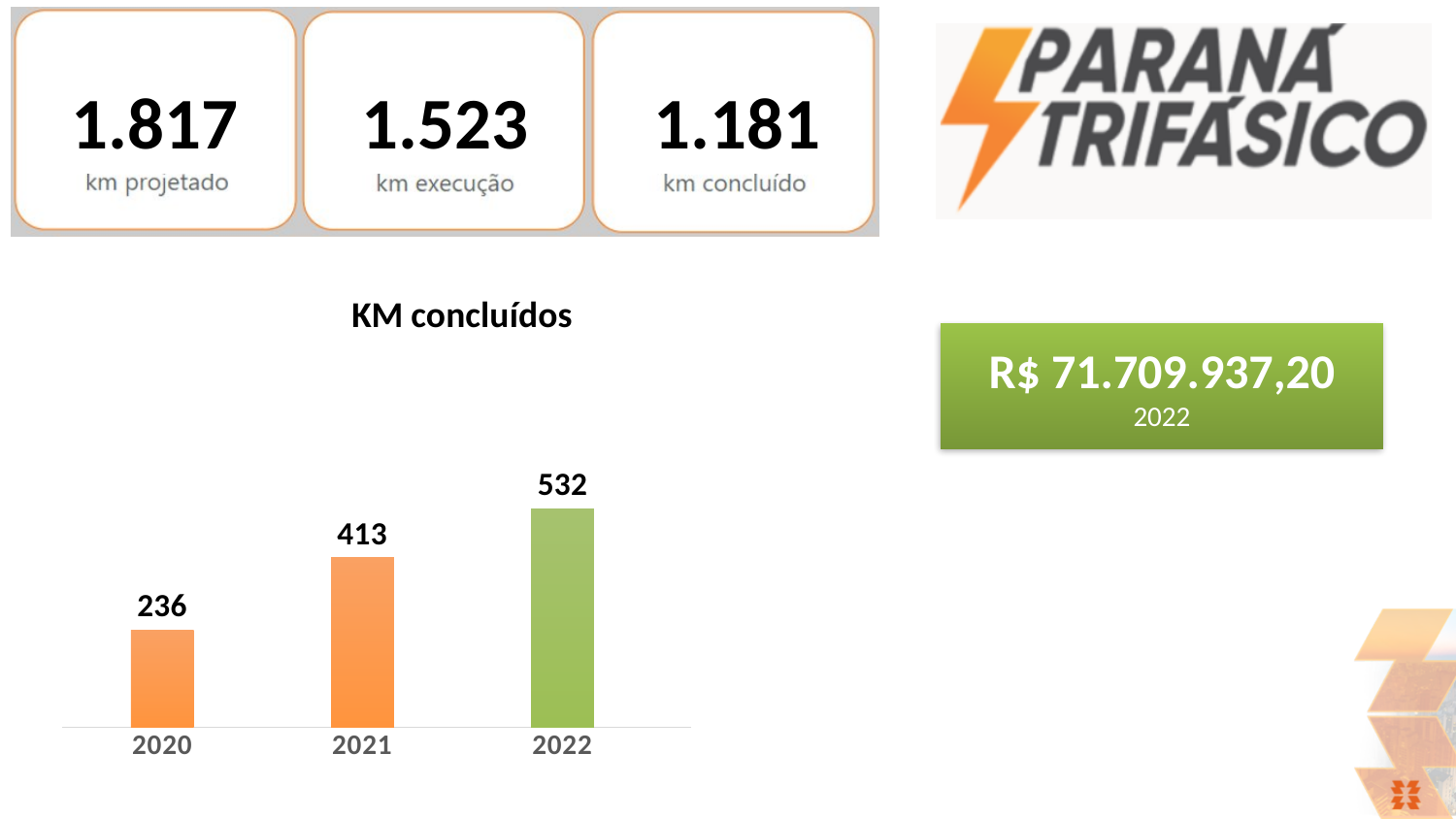
What is the difference between the 2022 and 2021 values in the KM concluídos chart? 119 Which year has the highest value in the KM concluídos chart? 2022 What is the title of the chart on the slide? KM concluídos What kind of chart is the KM concluídos chart? bar chart Which year has the lowest value in the KM concluídos chart? 2020 Which is larger in the KM concluídos chart, the value for 2020 or the value for 2021? 2021 What is the value for 2021 in the KM concluídos chart? 413 Do the values in the KM concluídos chart rise or fall from 2020 to 2022? rise How many years are shown in the KM concluídos chart? 3 What is the difference between the 2021 and 2020 values in the KM concluídos chart? 177 What is the value for 2020 in the KM concluídos chart? 236 What is the value for 2022 in the KM concluídos chart? 532